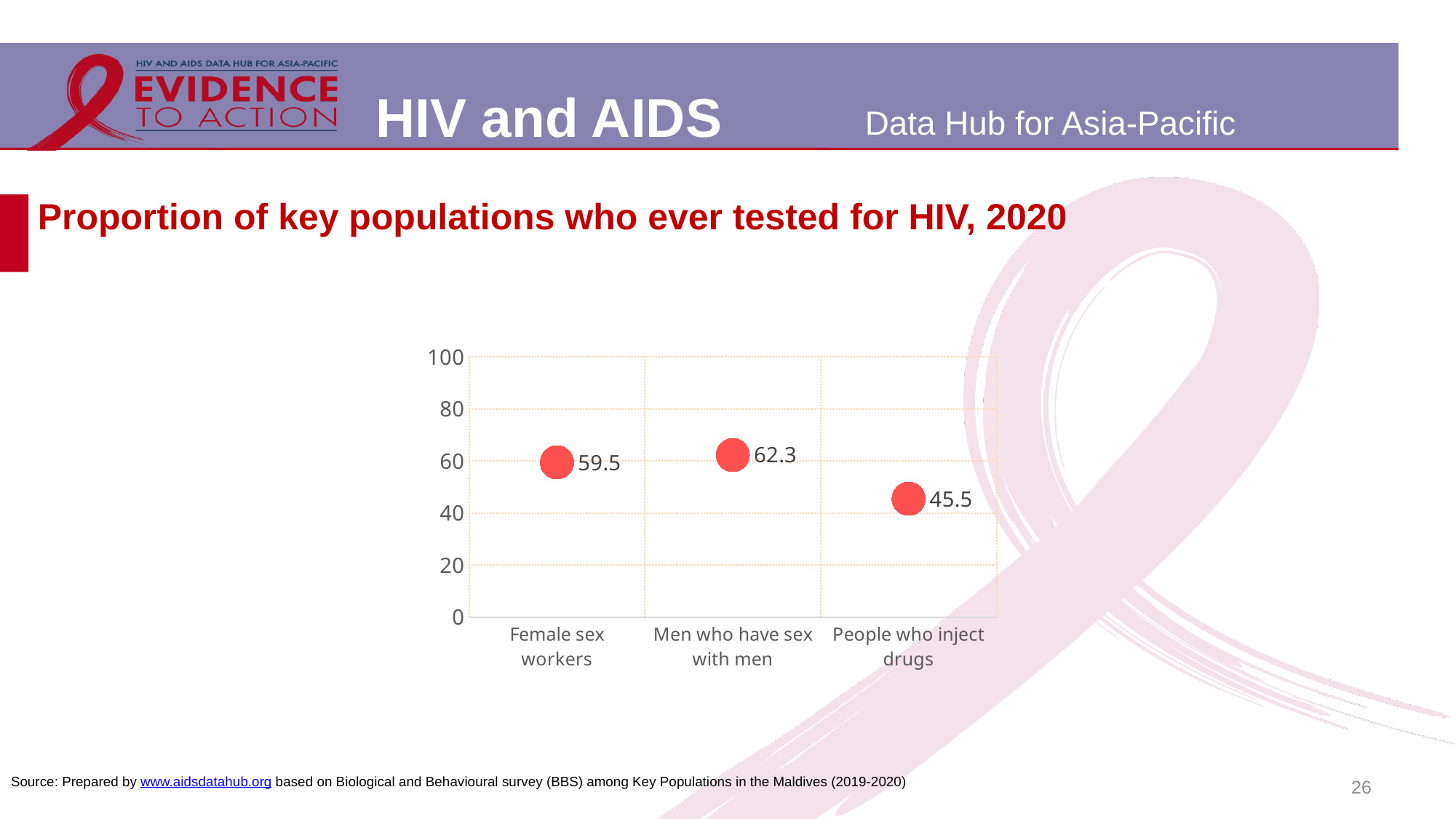
Which key population has the lowest proportion ever tested for HIV? People who inject drugs What is the title of the chart on the slide? Proportion of key populations who ever tested for HIV, 2020 How many key populations are plotted on the chart? 3 What is the value for Men who have sex with men? 62.3 What is the value for People who inject drugs? 45.5 Which is larger, the value for Female sex workers or the value for People who inject drugs? Female sex workers Which key population has the highest proportion ever tested for HIV? Men who have sex with men What is the difference between the values for Female sex workers and People who inject drugs? 14 What kind of chart is shown on the slide? Scatter chart What is the difference between the values for Men who have sex with men and People who inject drugs? 16.8 What is the value for Female sex workers? 59.5 Is the value for People who inject drugs greater or less than 60? less